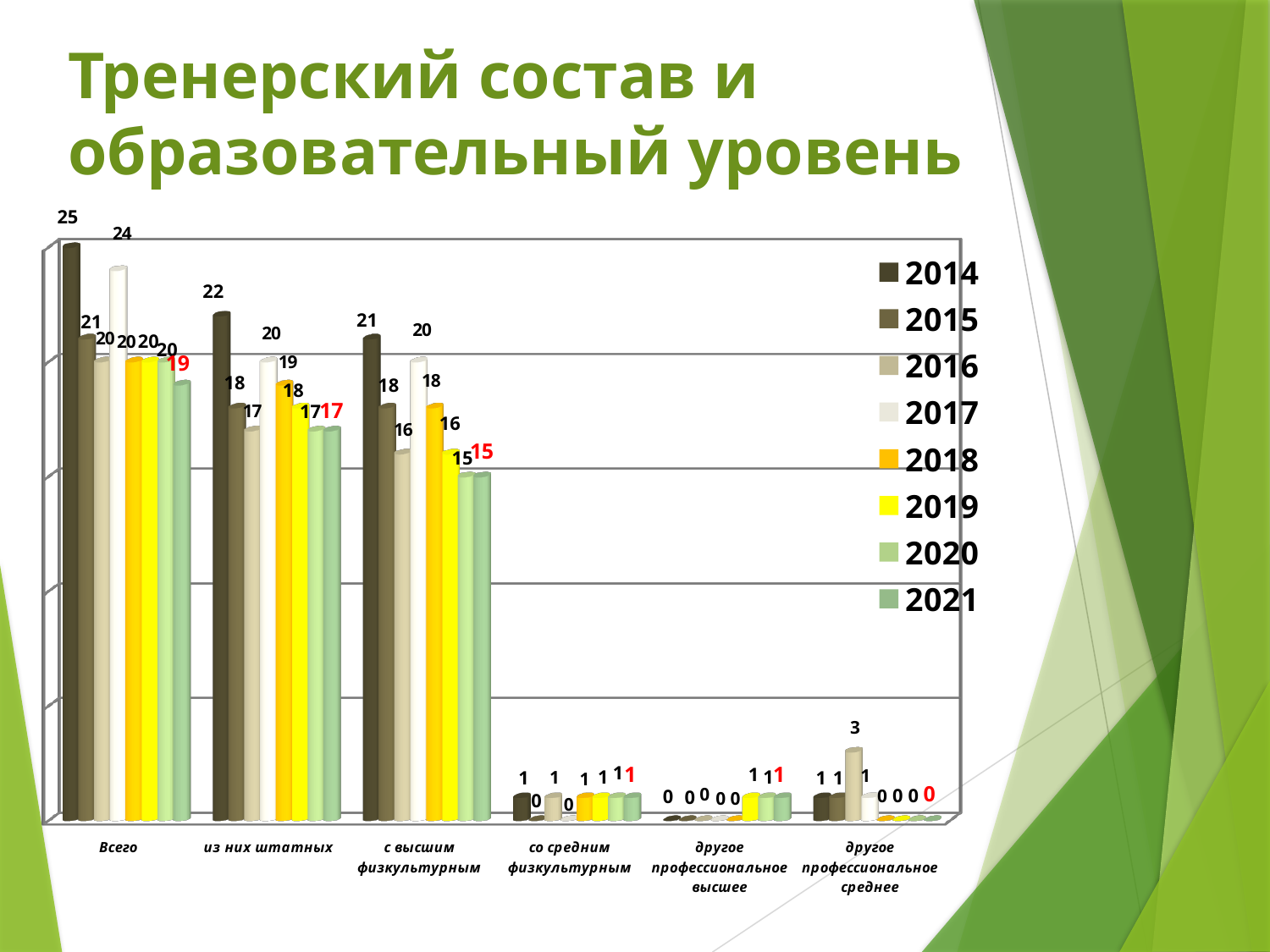
How many series does the legend list? 8 Which year's legend entry is shown in orange? 2018 What type of chart is shown on the slide? bar chart How many categories are shown on the x axis? 6 What is the value for 2014 in the 'Всего' category? 25 What is the value for 2016 in the 'другое профессиональное среднее' category? 3 Which year has the highest value in the 'Всего' category? 2014 Which year has the lowest value in the 'из них штатных' category among 2014, 2015, 2017 and 2018? 2015 What is the value for 2017 in the 'из них штатных' category? 20 In the 'с высшим физкультурным' category, which is larger: the value for 2017 or the value for 2018? 2017 What is the value for 2021 in the 'Всего' category? 19 What is the difference between the 2014 and 2021 values in the 'с высшим физкультурным' category? 6